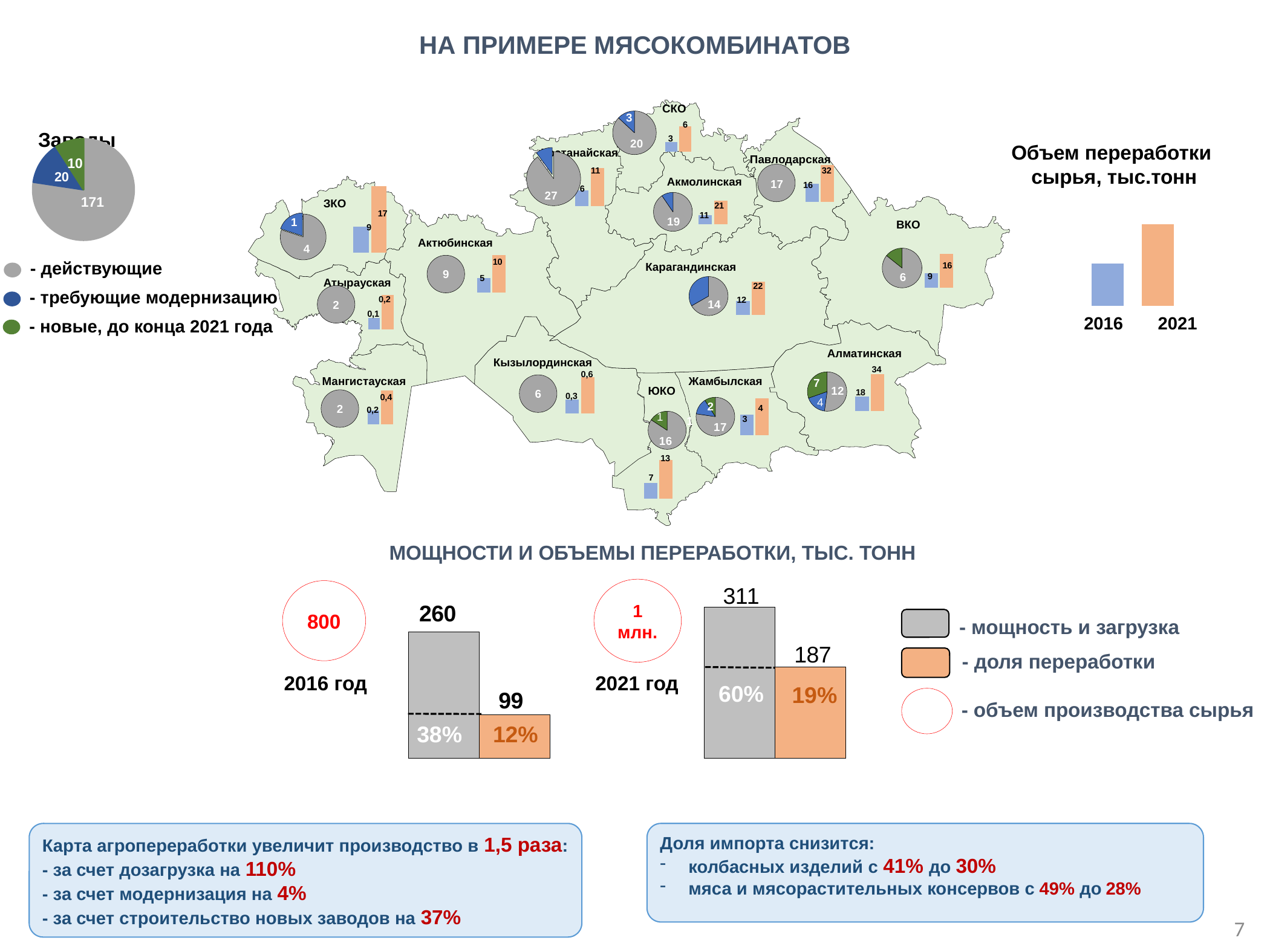
On the map, which is larger: the 2021 processing volume for Карагандинская or for Акмолинская? Карагандинская On the map, what is the difference between the 2021 and 2016 processing volumes for ЗКО? 8 On the map, what is the 2021 processing volume (тыс. тонн) for Павлодарская region? 32 In the 'Заводы' pie chart, what is the difference between the 'действующие' and 'требующие модернизацию' values? 151 What kind of chart is the 'Мощности и объемы переработки, тыс. тонн' chart? bar chart On the map, how many series does the processing-volume legend list? 2 In the 'Мощности и объемы переработки, тыс. тонн' chart, what is the 'доля переработки' value for 2016? 99 On the map, what is the 2016 processing volume (тыс. тонн) for Алматинская region? 18 In the 'Заводы' pie chart, what is the value for the 'действующие' (grey) slice? 171 In the 'Заводы' pie chart, which category has the smallest value? новые, до конца 2021 года In the 'Мощности и объемы переработки, тыс. тонн' chart, what is the 'мощность и загрузка' value for 2021? 311 In the 'Мощности и объемы переработки, тыс. тонн' chart, what is the difference between the 'доля переработки' values for 2021 and 2016? 88